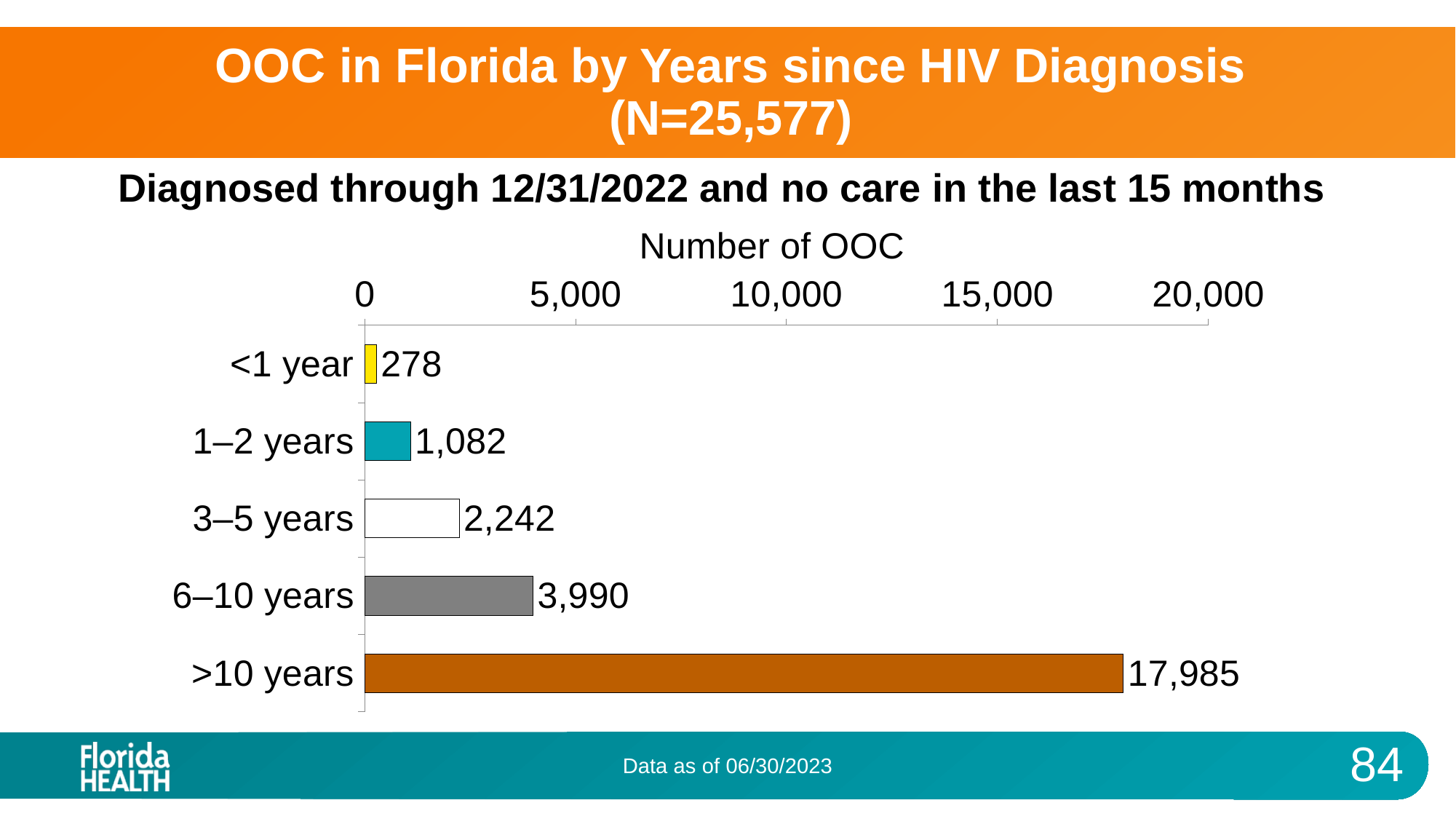
Is the value for >10 years greater or less than 15,000? greater What is the number of OOC for the >10 years category? 17,985 What is the number of OOC for the 3–5 years category? 2,242 Which has a larger number of OOC, 1–2 years or 3–5 years? 3–5 years What is the difference in number of OOC between the 6–10 years and 3–5 years categories? 1,748 What kind of chart is shown on the slide? Bar chart How many categories are shown in the chart? 5 What is the number of OOC for the 6–10 years category? 3,990 What is the title of the chart's horizontal axis? Number of OOC What is the number of OOC for the <1 year category? 278 Which category has the highest number of OOC? >10 years Which category has the lowest number of OOC? <1 year